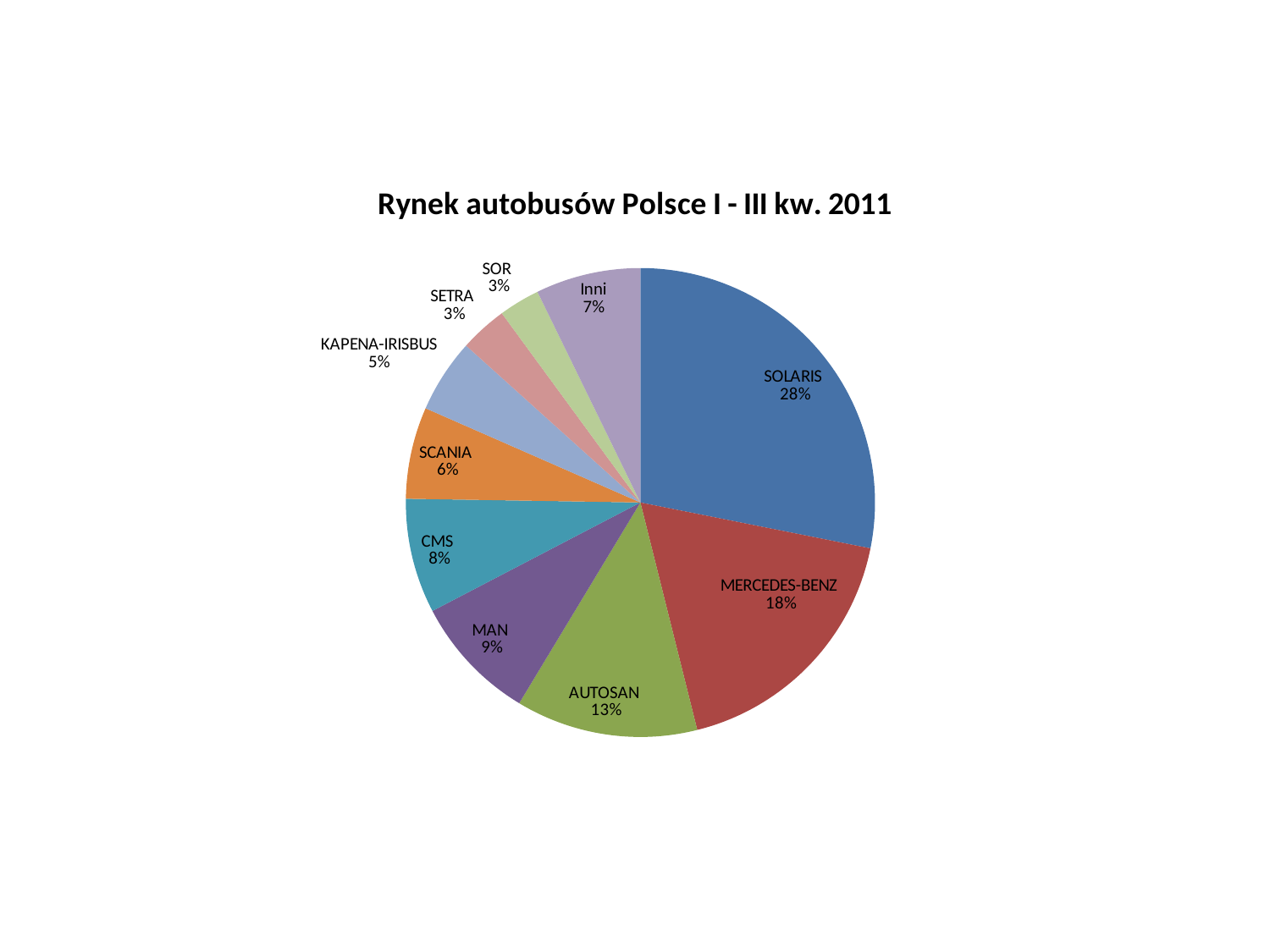
What is the value shown for MERCEDES-BENZ? 18% What kind of chart is shown on the slide? Pie chart Which category has the largest slice of the pie? SOLARIS What is the combined share of SETRA and SOR? 6% What is the value shown for AUTOSAN? 13% What is the value shown for KAPENA-IRISBUS? 5% What share of the pie does CMS hold? 8% Which is larger, the share for MAN or the share for SCANIA? MAN What is the difference between the shares of SOLARIS and MERCEDES-BENZ? 10% What is the title of the chart? Rynek autobusów Polsce I - III kw. 2011 What share of the pie does SOLARIS hold? 28% How many slices does the pie chart have? 10